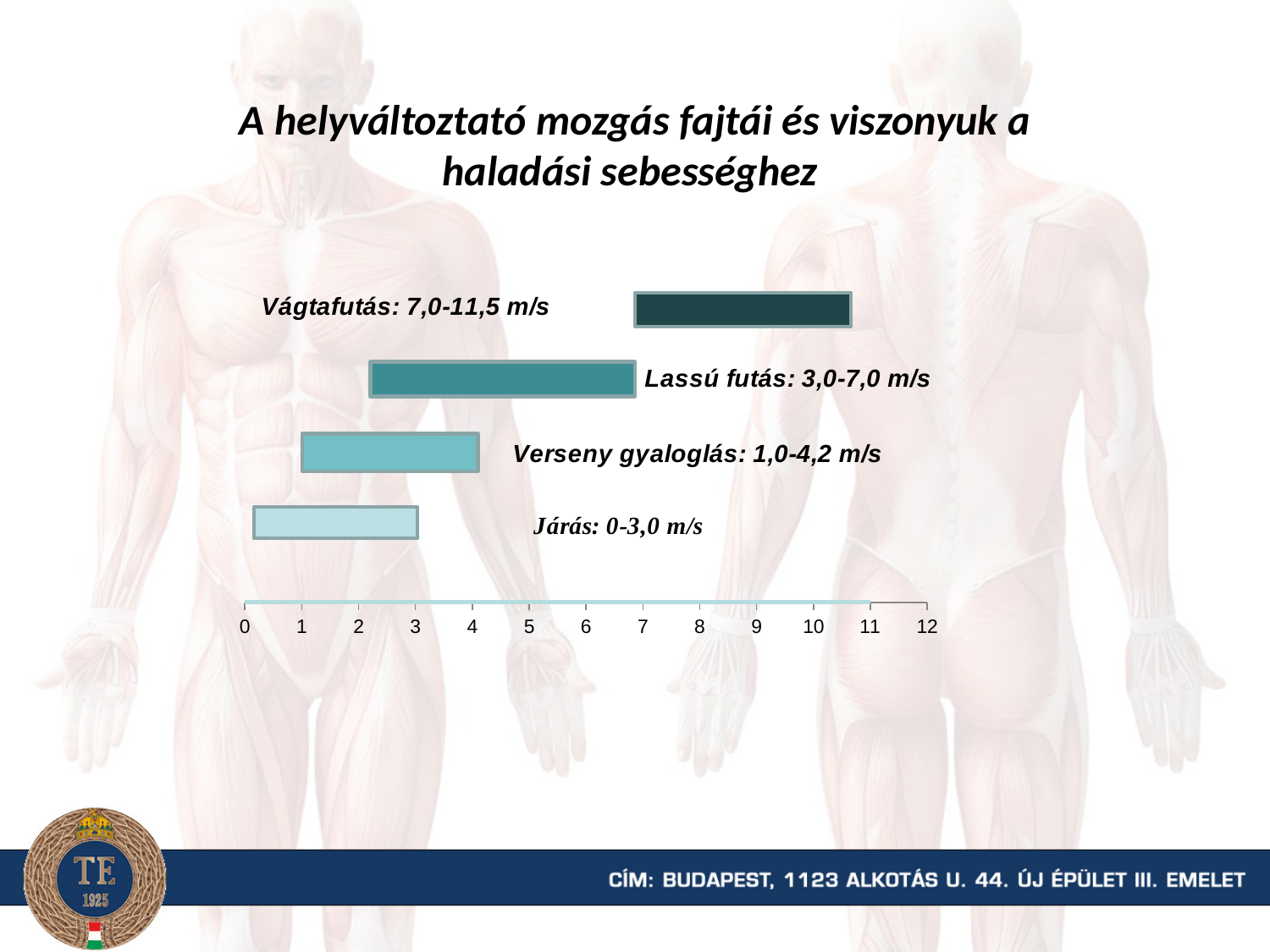
How many types of movement are plotted on the chart? 4 What is the difference between the upper speed limits of Vágtafutás and Lassú futás? 4,5 m/s What speed range is shown for Verseny gyaloglás? 1,0-4,2 m/s Which type of movement reaches the highest speed on the chart? Vágtafutás What speed range is shown for Járás? 0-3,0 m/s Is the upper speed limit of Vágtafutás greater or less than 10 m/s? greater Which has a higher upper speed limit, Verseny gyaloglás or Lassú futás? Lassú futás Is the upper speed limit of Lassú futás greater or less than 8 m/s? less What speed range is shown for Vágtafutás? 7,0-11,5 m/s What speed range is shown for Lassú futás? 3,0-7,0 m/s Which type of movement has the lowest upper speed limit on the chart? Járás What kind of chart is shown on the slide? Bar chart